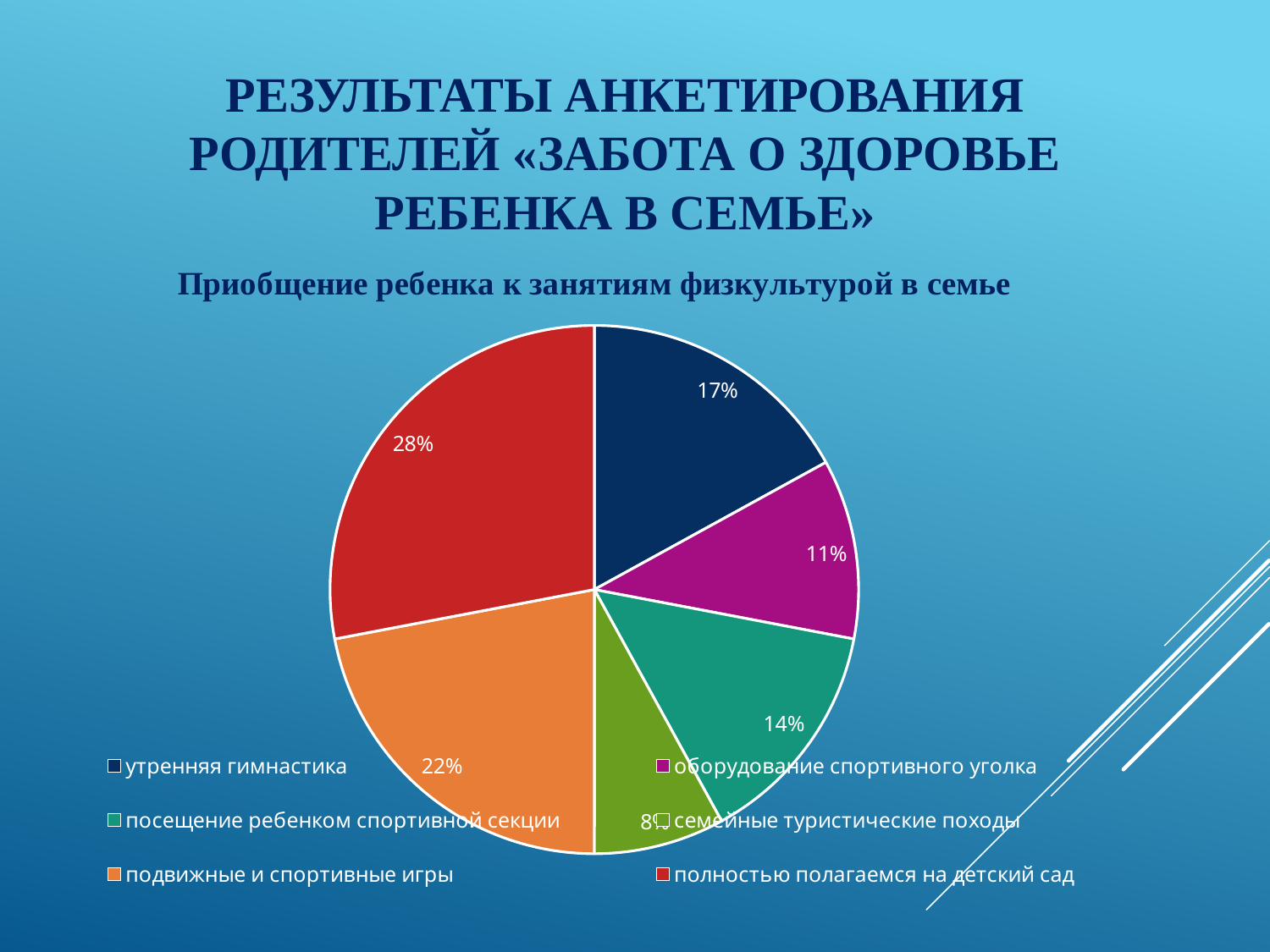
What is the title of the chart? Приобщение ребенка к занятиям физкультурой в семье How many categories does the pie chart have? 6 Which category has the largest share of the pie? полностью полагаемся на детский сад What percentage is shown for «посещение ребенком спортивной секции»? 14% What kind of chart is shown on the slide? pie chart What percentage is shown for «подвижные и спортивные игры»? 22% What percentage is shown for «полностью полагаемся на детский сад»? 28% Which category has the smallest share of the pie? семейные туристические походы What percentage is shown for «оборудование спортивного уголка»? 11% How many percentage points larger is «полностью полагаемся на детский сад» than «подвижные и спортивные игры»? 6 What percentage is shown for «утренняя гимнастика»? 17% Which is larger: «утренняя гимнастика» or «посещение ребенком спортивной секции»? утренняя гимнастика